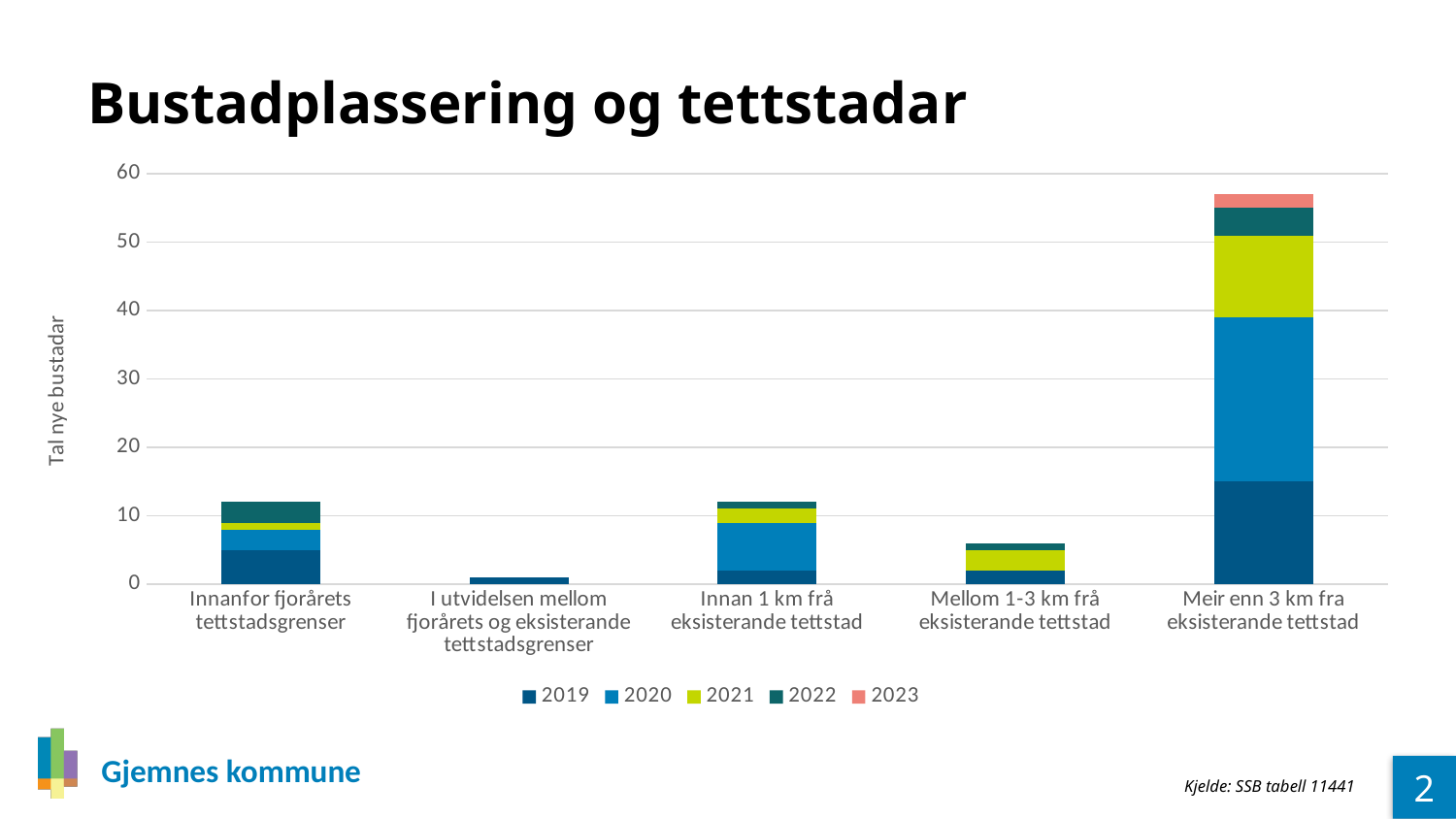
Which category has the tallest stacked bar? Meir enn 3 km fra eksisterande tettstad Which category has the shortest stacked bar? I utvidelsen mellom fjorårets og eksisterande tettstadsgrenser How many series does the legend list? 5 Is the total stacked value for 'Innanfor fjorårets tettstadsgrenser' greater or less than 10? greater What is the label on the vertical axis? Tal nye bustadar Which category is the only one with a visible 2023 segment? Meir enn 3 km fra eksisterande tettstad How many categories are shown along the x axis? 5 Which has the larger total: 'Innanfor fjorårets tettstadsgrenser' or 'Mellom 1-3 km frå eksisterande tettstad'? Innanfor fjorårets tettstadsgrenser Is the total stacked value for 'Meir enn 3 km fra eksisterande tettstad' greater or less than 50? greater Is the total stacked value for 'Mellom 1-3 km frå eksisterande tettstad' greater or less than 10? less What kind of chart is shown on the slide? Stacked bar chart Which series is listed first in the legend? 2019